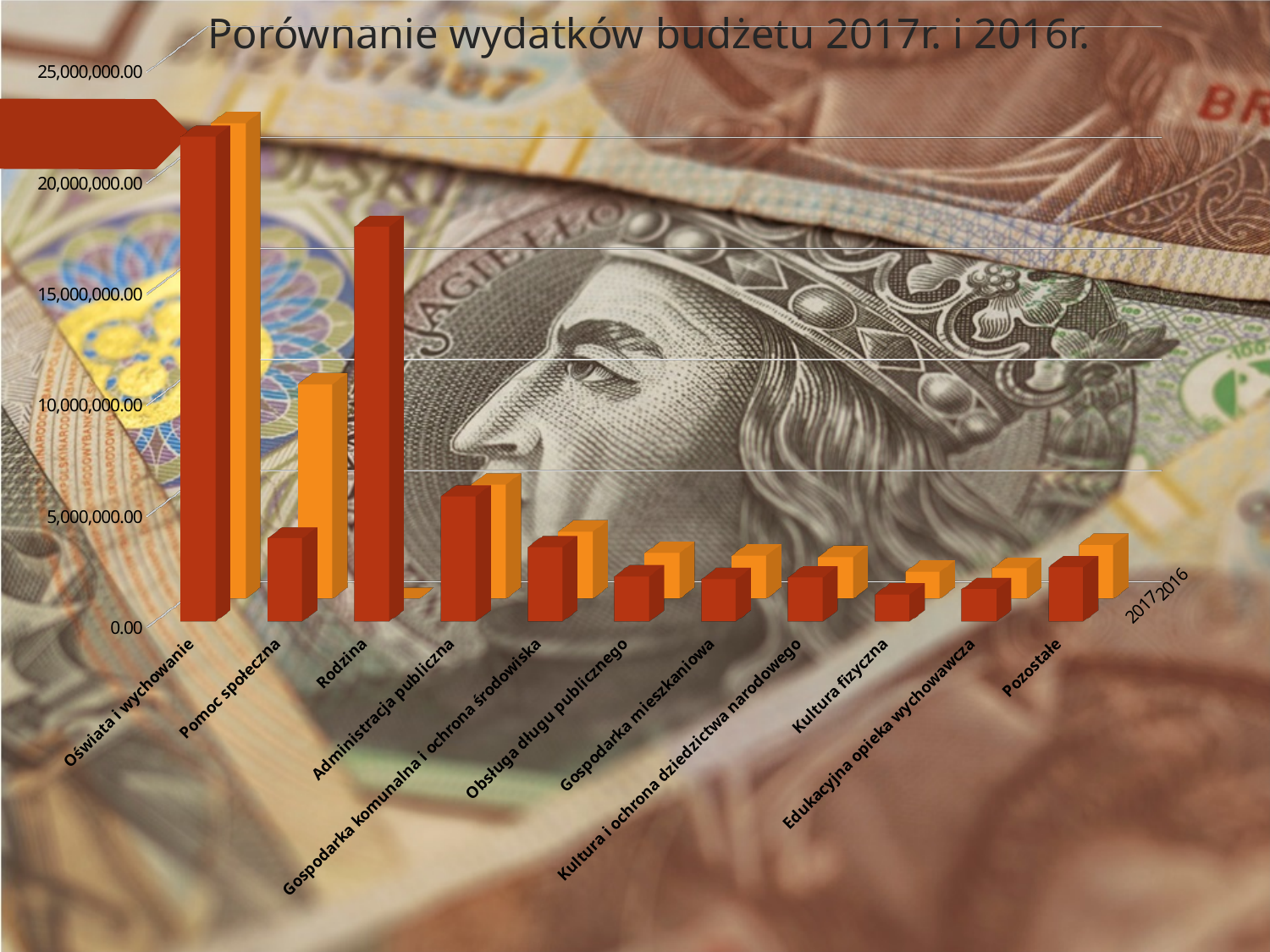
Which category has the highest value for the 2017 series? Oświata i wychowanie Is the 2017 value for Oświata i wychowanie greater or less than 20,000,000.00? greater What type of chart is shown on the slide? bar chart Is the 2017 value for Rodzina greater or less than 15,000,000.00? greater For Pomoc społeczna, which series has the larger value, 2017 or 2016? 2016 Which category has the lowest value for the 2016 series? Rodzina Is the 2017 value for Pomoc społeczna greater or less than 5,000,000.00? less How many categories are shown on the x axis of the chart? 11 For Rodzina, which series has the larger value, 2017 or 2016? 2017 What is the title of the chart? Porównanie wydatków budżetu 2017r. i 2016r.